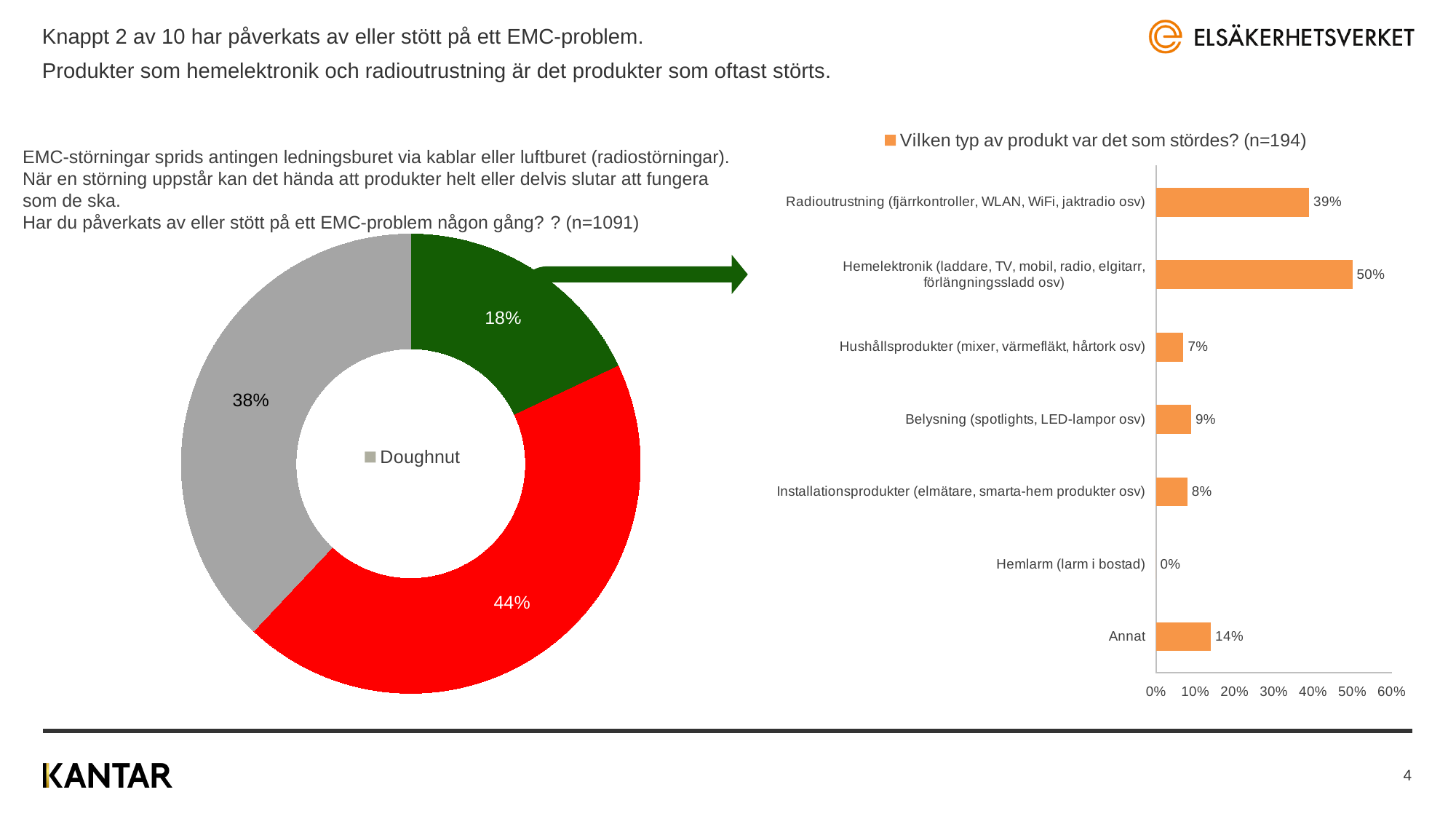
In the bar chart 'Vilken typ av produkt var det som stördes?', what is the value for Hemelektronik? 50% In the bar chart 'Vilken typ av produkt var det som stördes?', what is the difference between Hemelektronik and Radioutrustning? 11% In the doughnut chart on the left, what value does the green slice show? 18% What kind of chart is the chart on the left side of the slide? Doughnut chart What kind of chart is the chart on the right side of the slide? Bar chart In the doughnut chart on the left, what value does the red slice show? 44% How many categories are shown in the bar chart 'Vilken typ av produkt var det som stördes?'? 7 In the bar chart 'Vilken typ av produkt var det som stördes?', what is the value for Radioutrustning? 39% In the bar chart 'Vilken typ av produkt var det som stördes?', which category has the highest value? Hemelektronik In the bar chart 'Vilken typ av produkt var det som stördes?', which category has the lowest value? Hemlarm In the bar chart 'Vilken typ av produkt var det som stördes?', which is larger, Belysning or Hushållsprodukter? Belysning In the bar chart 'Vilken typ av produkt var det som stördes?', what is the value for Annat? 14%